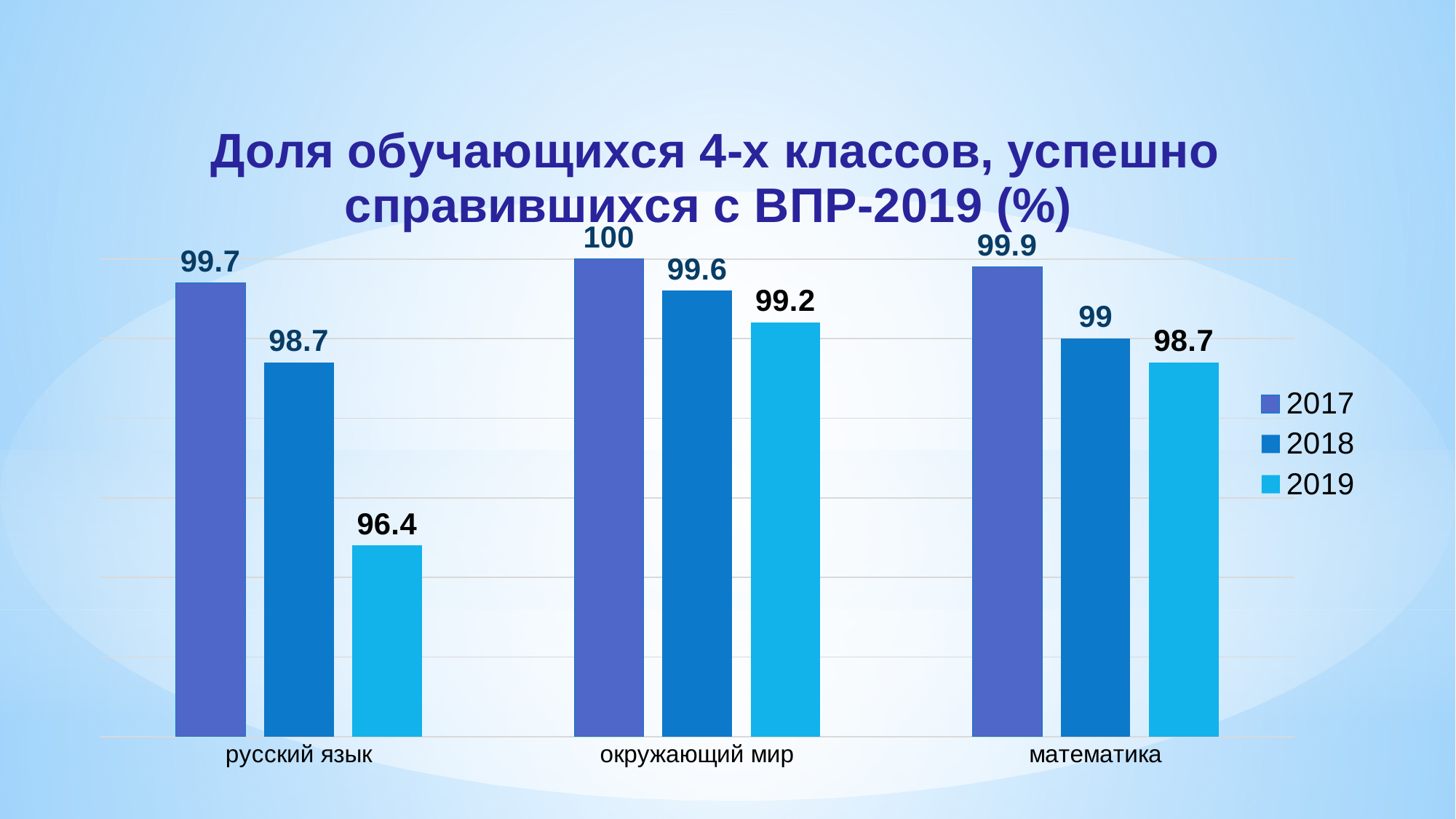
Which subject has the lowest value in 2019? русский язык How many series does the legend list? 3 Which subject has the highest value in 2017? окружающий мир What is the difference between the 2017 and 2019 values for русский язык? 3.3 What is the value for русский язык in 2019? 96.4 Which is larger: the 2019 value for окружающий мир or the 2019 value for математика? окружающий мир What kind of chart is shown on the slide? bar chart What is the difference between the 2018 and 2019 values for математика? 0.3 What is the value for математика in 2018? 99 What is the value for окружающий мир in 2017? 100 For русский язык, do the values rise or fall from 2017 to 2019? fall How many subject categories are shown on the x axis? 3